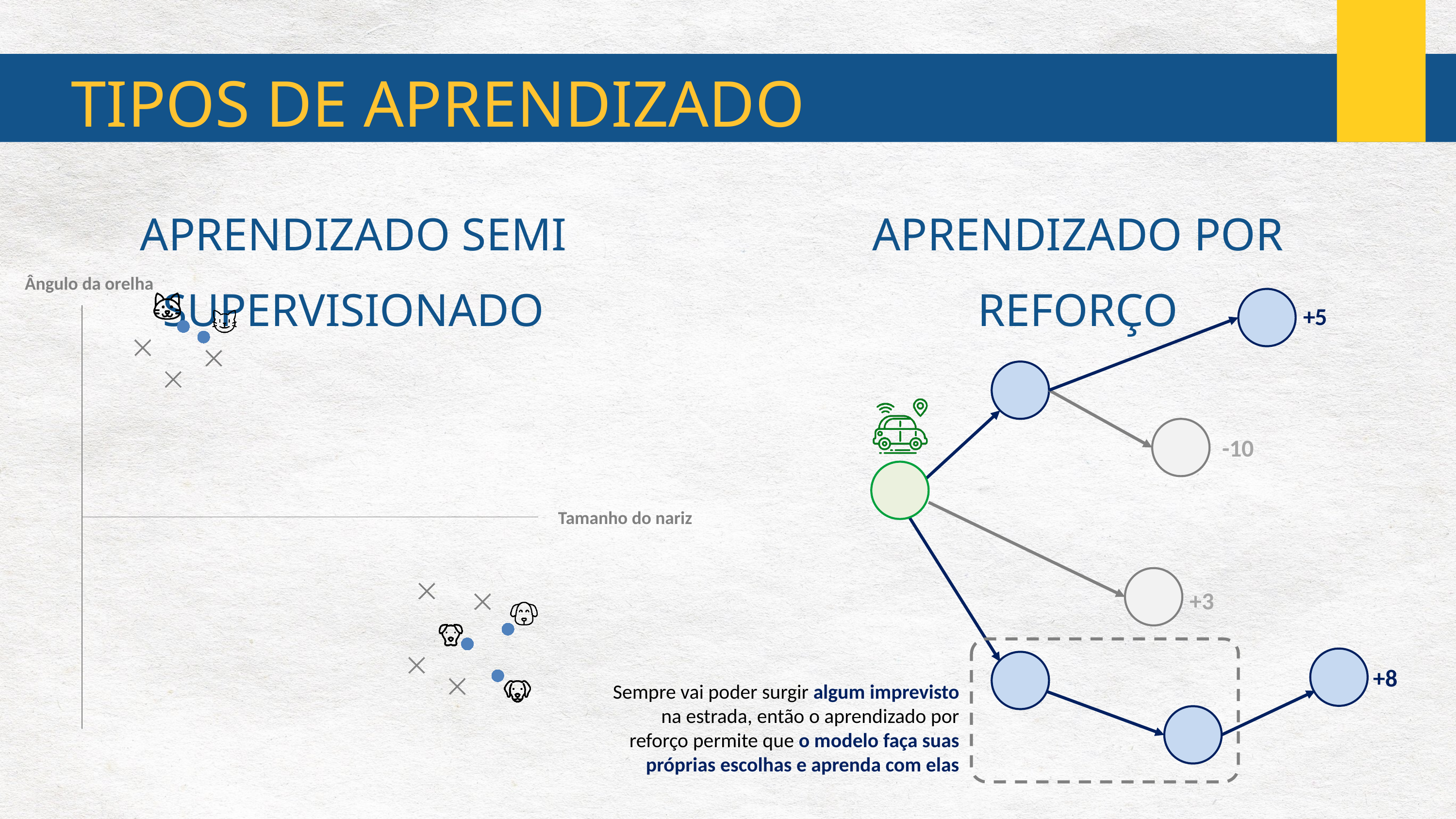
How many filled blue dots are plotted in the cat cluster of the scatter chart on the left? 2 How many filled blue dots are plotted in the dog cluster of the scatter chart on the left? 3 How many distinct clusters of points are shown in the scatter chart on the left? 2 What kind of chart is shown on the left side of the slide under 'Aprendizado semi supervisionado'? scatter chart In the scatter chart on the left, which animal group has the higher values on the 'Ângulo da orelha' axis, the cats or the dogs? cats What is the label of the vertical axis of the scatter chart on the left? Ângulo da orelha What is the label of the horizontal axis of the scatter chart on the left? Tamanho do nariz In the scatter chart on the left, which animal group has the larger values on the 'Tamanho do nariz' axis, the cats or the dogs? dogs